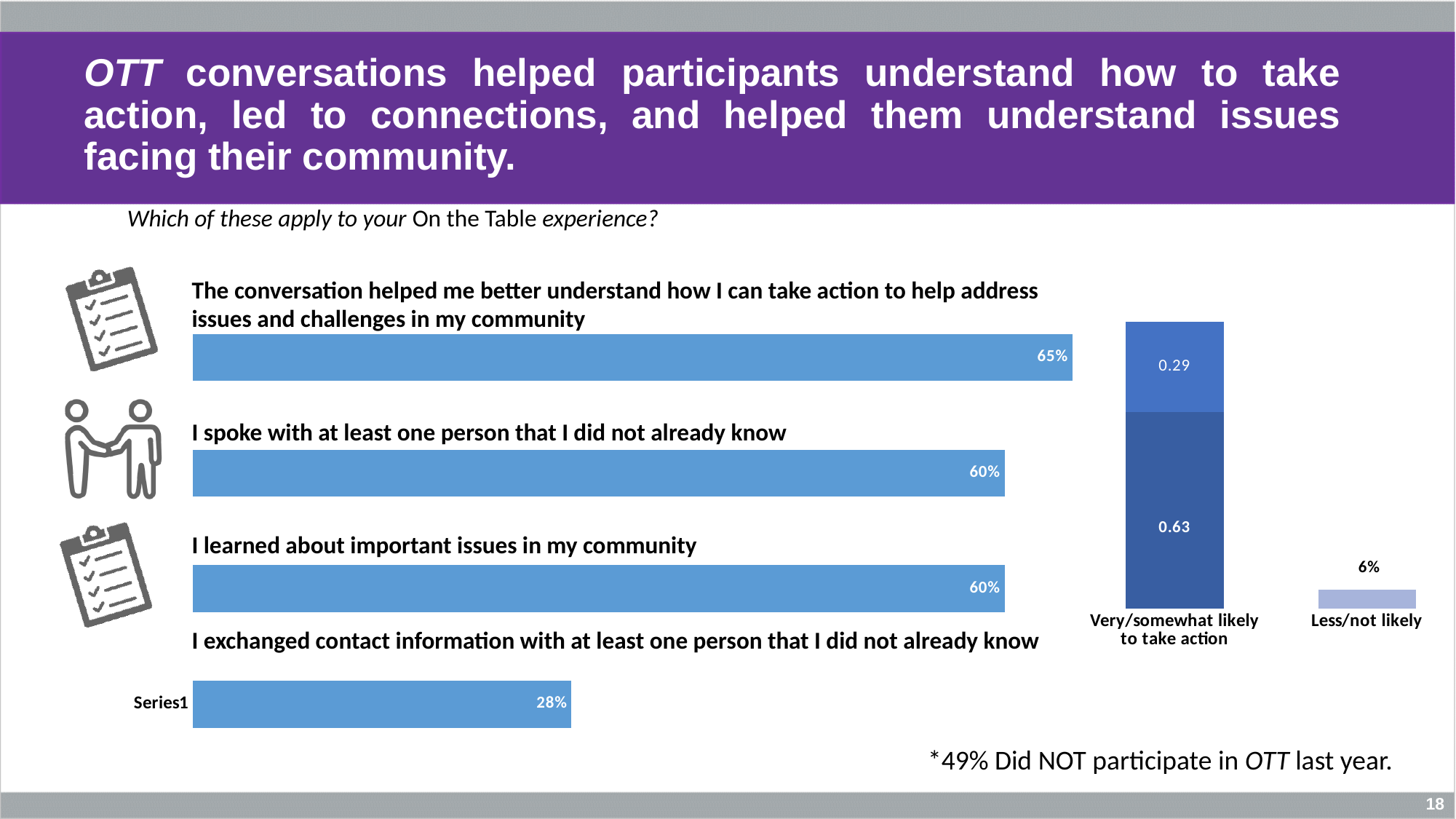
In the horizontal bar chart on the left, which statement has the lowest percentage? I exchanged contact information with at least one person that I did not already know In the stacked bar chart on the right, which category is larger: 'Very/somewhat likely to take action' or 'Less/not likely'? Very/somewhat likely to take action How many bars are shown in the horizontal bar chart on the left? 4 In the horizontal bar chart on the left, what percentage of participants said the conversation helped them better understand how they can take action to help address issues and challenges in their community? 65% In the horizontal bar chart on the left, what percentage of participants said they spoke with at least one person they did not already know? 60% In the stacked bar chart on the right, what are the two segment values of the 'Very/somewhat likely to take action' bar? 0.63 and 0.29 What type of chart is the chart on the left of the slide? Bar chart In the stacked bar chart on the right, what value is shown for 'Less/not likely'? 6% In the horizontal bar chart on the left, which statement has the highest percentage? The conversation helped me better understand how I can take action to help address issues and challenges in my community In the stacked bar chart on the right, what is the total of the 'Very/somewhat likely to take action' bar (0.63 + 0.29)? 0.92 In the horizontal bar chart on the left, what percentage of participants said they exchanged contact information with at least one person they did not already know? 28% In the horizontal bar chart on the left, what is the difference between the highest bar (65%) and the lowest bar (28%)? 37%